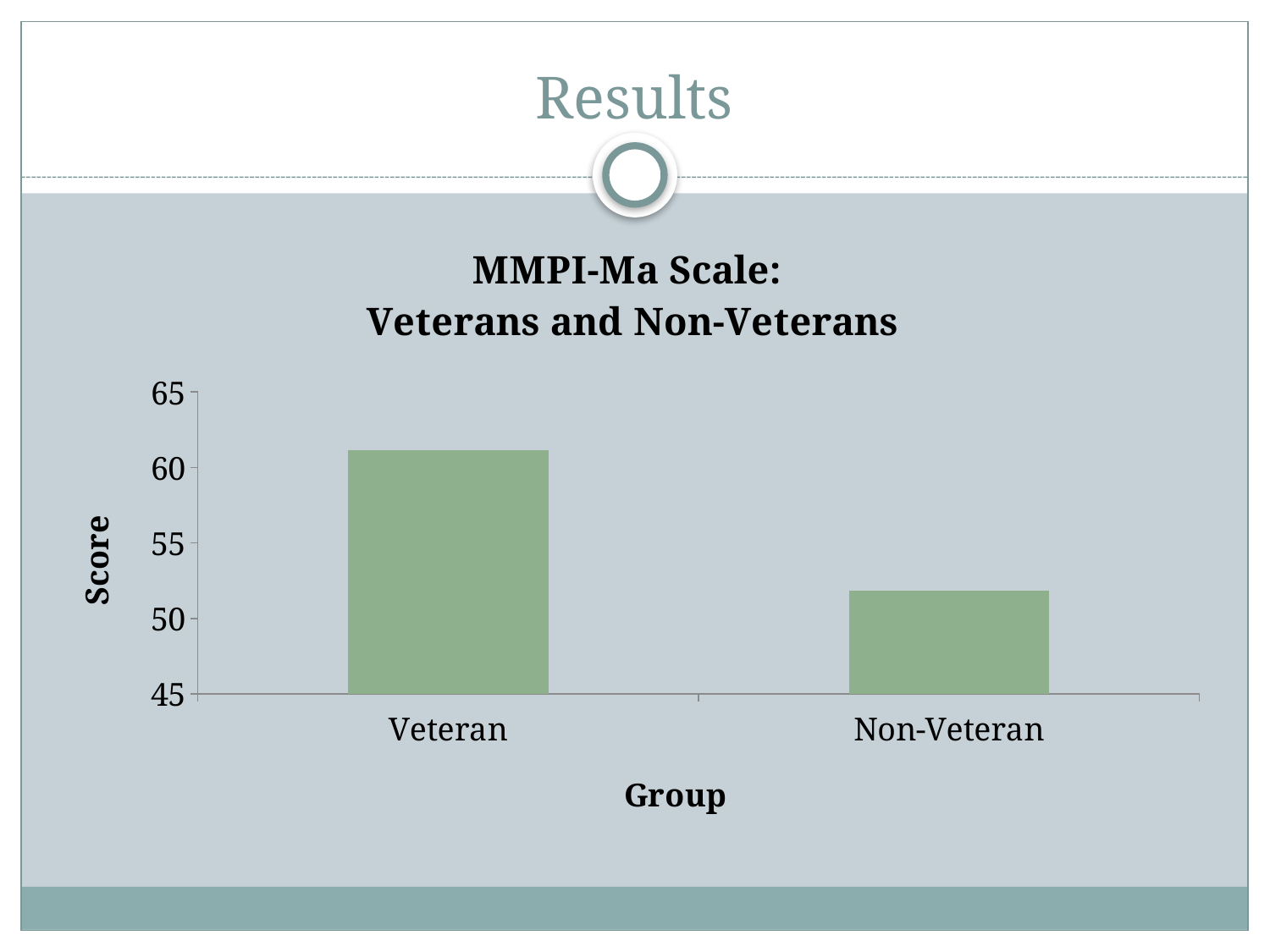
What kind of chart is shown on the slide? bar chart Which group has the lower score? Non-Veteran Is the score for Veteran greater or less than 60? greater Which group has the higher score? Veteran What is the title of the chart? MMPI-Ma Scale: Veterans and Non-Veterans Do the scores rise or fall from Veteran to Non-Veteran along the x axis? fall Is the score for Veteran greater or less than 65? less What is the label of the vertical axis? Score Which is larger, the score for Veteran or the score for Non-Veteran? Veteran Is the score for Non-Veteran greater or less than 55? less How many groups are plotted in the chart? 2